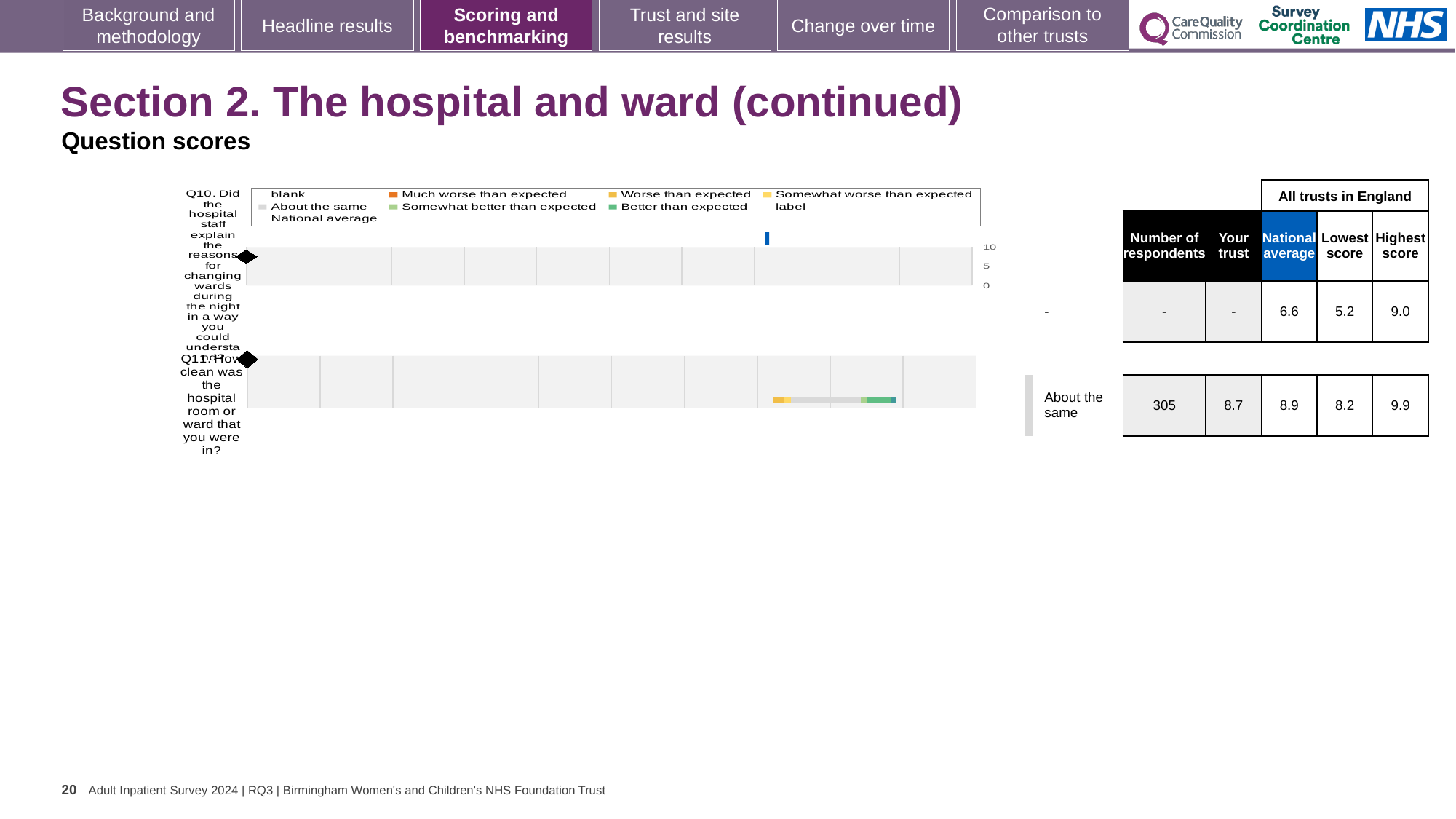
What is the national average score for Q10? 6.6 What benchmark category is shown for Q11? About the same How many questions (categories) are plotted on the chart? 2 What kind of chart is shown on the slide? bar chart How many entries does the chart legend list? 9 What is the highest score among all trusts in England for Q11? 9.9 For Q11, which is larger: the 'Your trust' score or the national average? National average What is the 'Your trust' score for Q11 (How clean was the hospital room or ward that you were in?)? 8.7 What is the national average score for Q11? 8.9 What is the difference between the highest and lowest scores for Q10? 3.8 How many respondents answered Q11? 305 What is the difference between the highest and lowest scores for Q11? 1.7